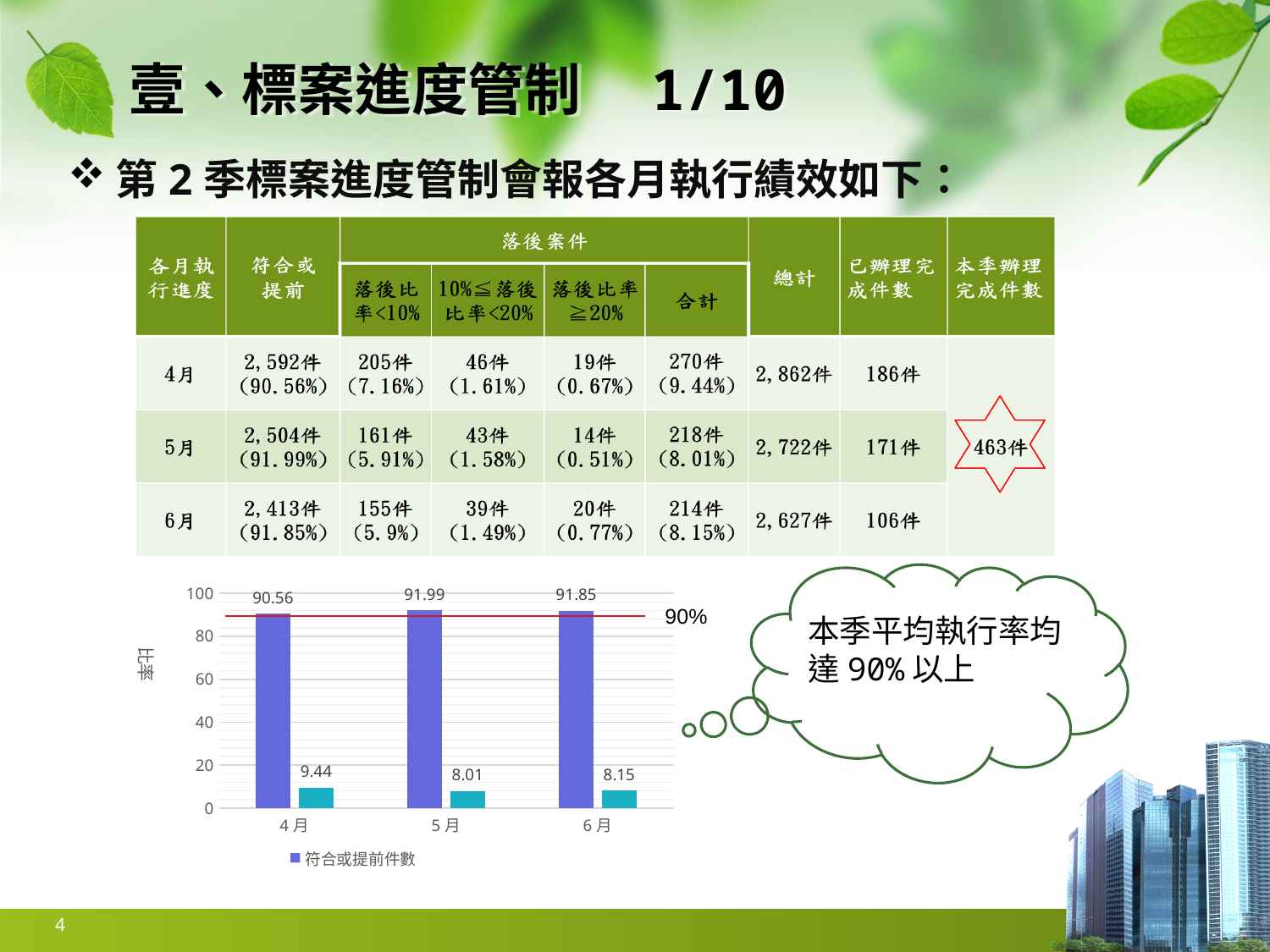
What is the value labelled on the smaller teal bar for 4月? 9.44 Which month has the lowest 符合或提前件數 value? 4月 What is the value of the 符合或提前件數 bar for 5月? 91.99 What is the value of the 符合或提前件數 bar for 4月? 90.56 What is the difference between the 符合或提前件數 values for 5月 and 4月? 1.43 How many months (categories) are shown on the x axis of the chart? 3 What is the value of the 符合或提前件數 bar for 6月? 91.85 What type of chart is shown on the slide? bar chart Which month has the highest 符合或提前件數 value? 5月 What value does the red horizontal reference line on the chart mark? 90% What is the value labelled on the smaller teal bar for 5月? 8.01 How many series does the chart's legend list? 1